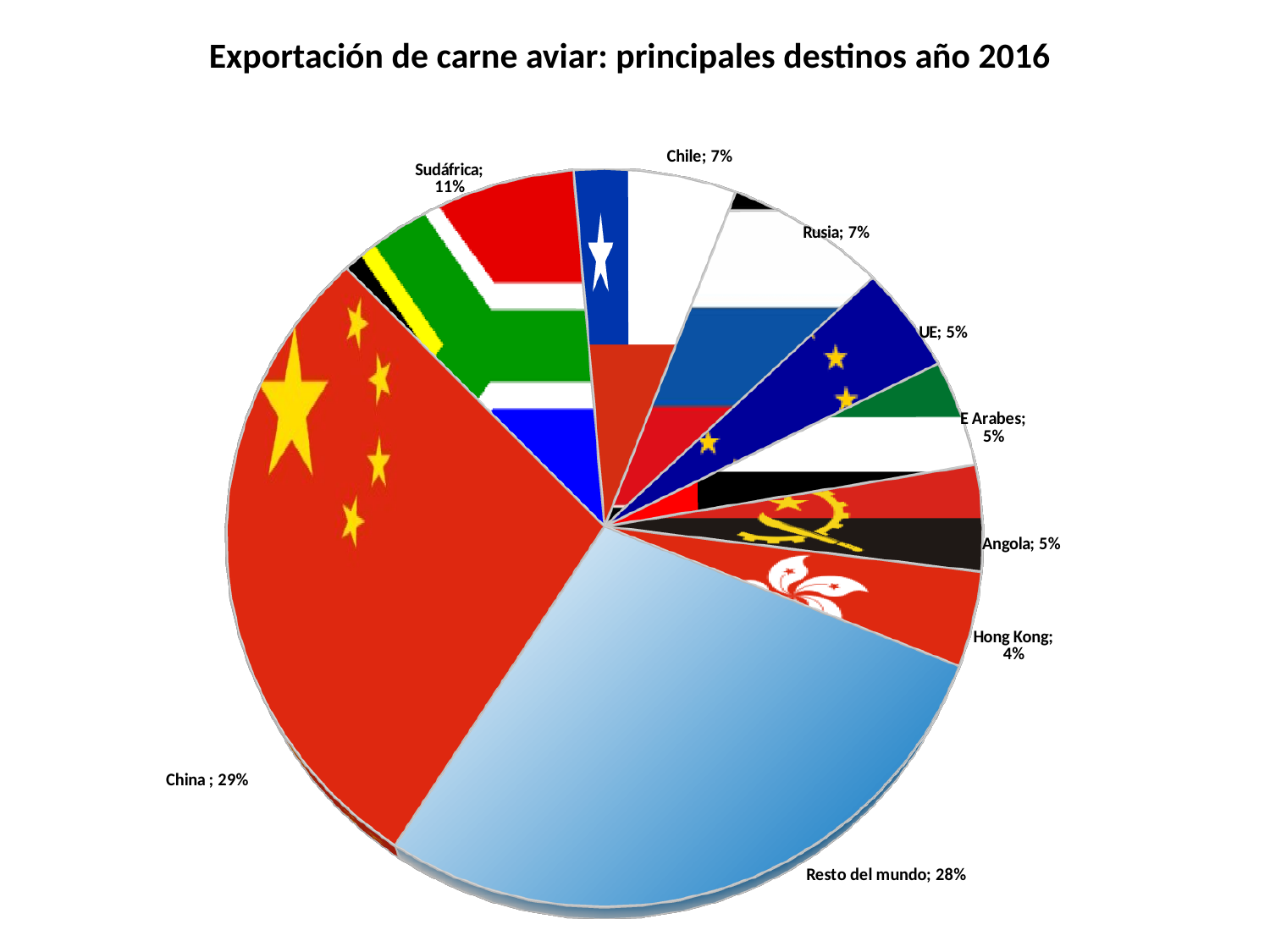
What is the difference between the shares of Sudáfrica and Chile? 4% Which category has the smallest slice of the pie? Hong Kong What is the difference between the shares of China and Resto del mundo? 1% Which category has the largest slice of the pie? China What is the value shown for Hong Kong? 4% How many slices does the pie chart have? 9 What is the value shown for Resto del mundo? 28% Which is larger, the share for Sudáfrica or the share for Angola? Sudáfrica What is the value shown for Sudáfrica? 11% What is the title of the chart? Exportación de carne aviar: principales destinos año 2016 What share of the pie does China have? 29% What kind of chart is shown on the slide? Pie chart